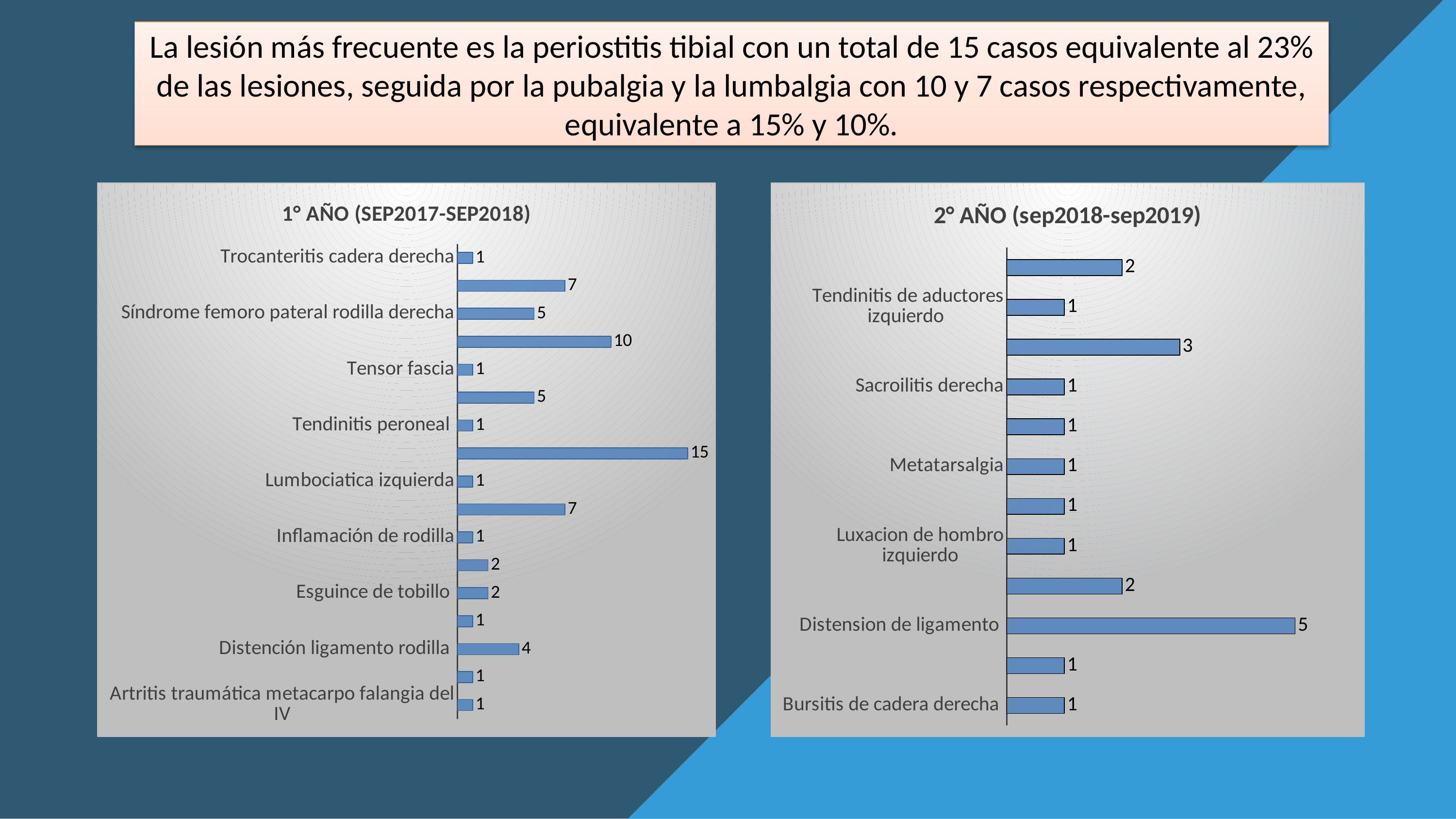
In the chart titled "1° AÑO (SEP2017-SEP2018)", what is the largest value shown on any bar? 15 In the chart titled "1° AÑO (SEP2017-SEP2018)", what is the difference between the values for Síndrome femoro pateral rodilla derecha and Distención ligamento rodilla? 1 How many bars are plotted in the chart titled "1° AÑO (SEP2017-SEP2018)"? 17 In the chart titled "2° AÑO (sep2018-sep2019)", what is the value for Distension de ligamento? 5 In the chart titled "1° AÑO (SEP2017-SEP2018)", what is the value for Esguince de tobillo? 2 In the chart titled "1° AÑO (SEP2017-SEP2018)", what is the value for Distención ligamento rodilla? 4 In the chart titled "1° AÑO (SEP2017-SEP2018)", which is larger: Esguince de tobillo or Distención ligamento rodilla? Distención ligamento rodilla In the chart titled "1° AÑO (SEP2017-SEP2018)", what is the value for Síndrome femoro pateral rodilla derecha? 5 How many bars are plotted in the chart titled "2° AÑO (sep2018-sep2019)"? 12 In the chart titled "2° AÑO (sep2018-sep2019)", what is the value for Metatarsalgia? 1 What kind of chart is the left chart on the slide? Bar chart In the chart titled "2° AÑO (sep2018-sep2019)", which category has the highest value? Distension de ligamento